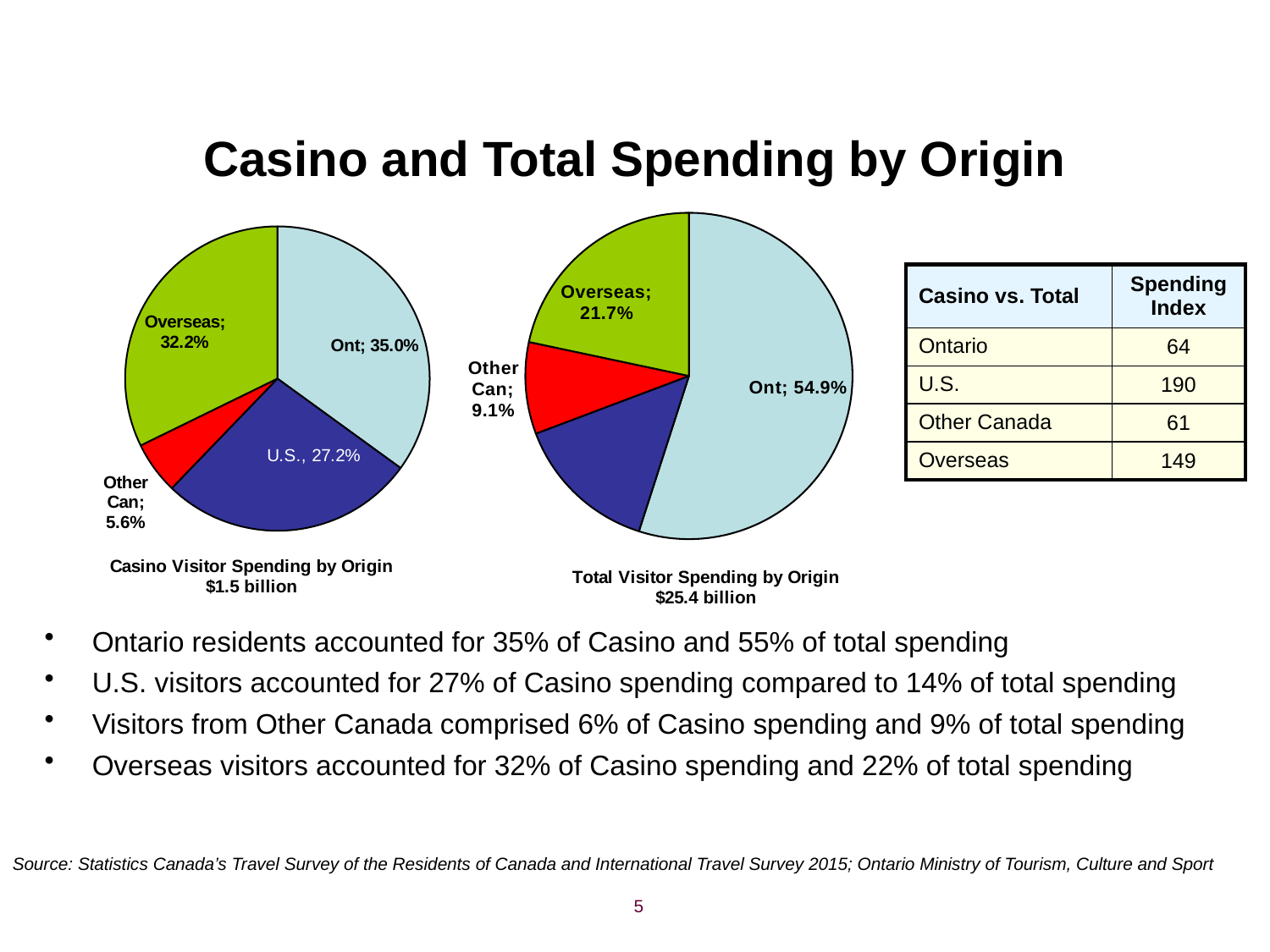
In the Total Visitor Spending by Origin chart, what share of spending comes from Overseas visitors? 21.7% What kind of chart is the Casino Visitor Spending by Origin chart? Pie chart In the Casino Visitor Spending by Origin chart, which origin has the largest share? Ont In the Casino Visitor Spending by Origin chart, what share of spending comes from Ontario? 35.0% In the Casino Visitor Spending by Origin chart, which origin has the smallest share? Other Can In the Casino Visitor Spending by Origin chart, what share of spending comes from Other Canada? 5.6% In the Casino Visitor Spending by Origin chart, which is larger, the Overseas share or the U.S. share? Overseas In the Total Visitor Spending by Origin chart, which origin has the largest share? Ont In the Casino Visitor Spending by Origin chart, what is the difference between the Overseas share and the U.S. share? 5.0% How many slices does the Total Visitor Spending by Origin pie chart have? 4 In the Total Visitor Spending by Origin chart, what share of spending comes from Ontario? 54.9% In the Casino Visitor Spending by Origin chart, what share of spending comes from the U.S.? 27.2%